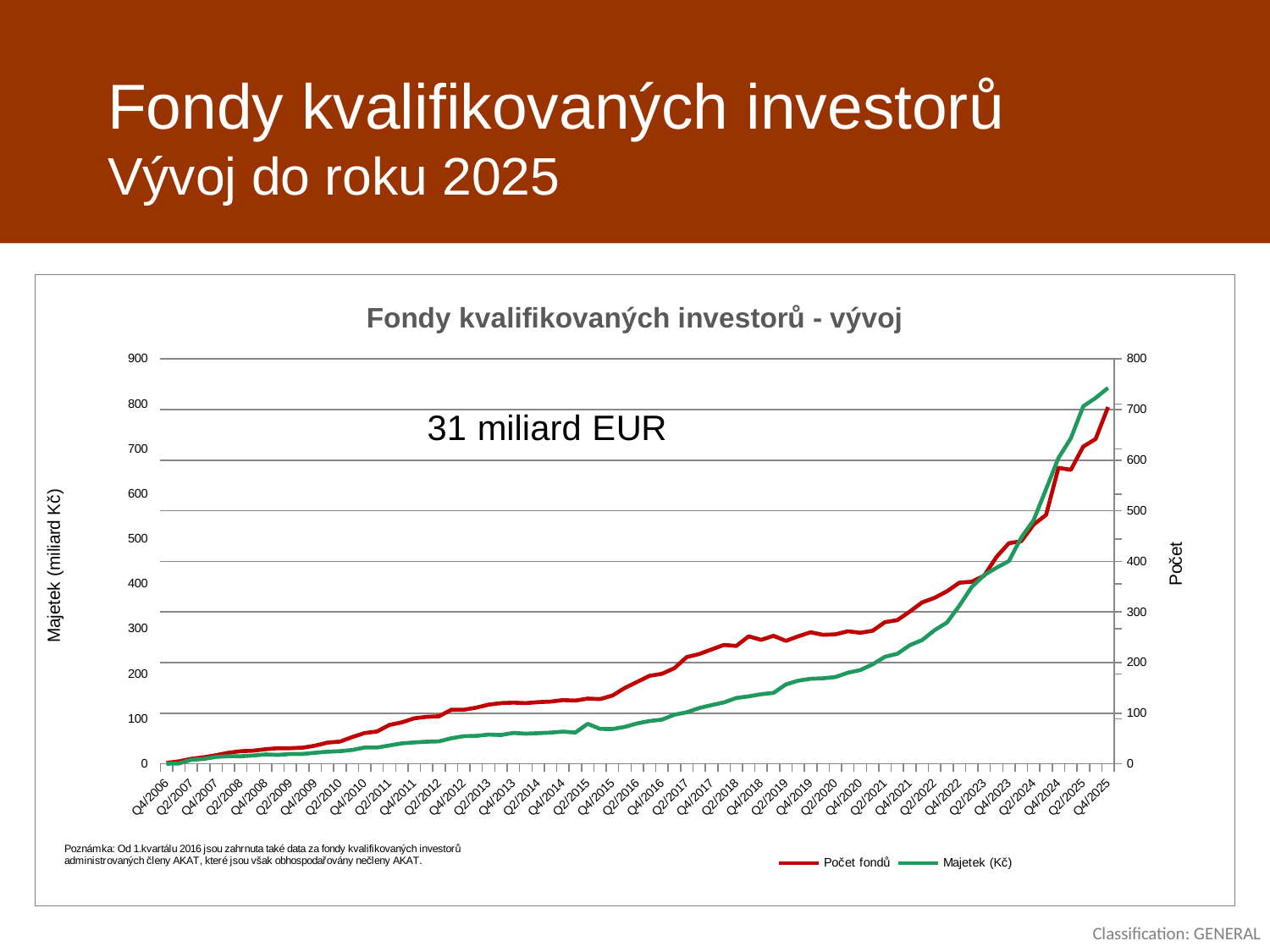
How many series does the chart legend list? 2 At Q4/2025, which line ends higher on the chart, Počet fondů or Majetek (Kč)? Majetek (Kč) What type of chart is shown on the slide? line chart What is the title of the chart? Fondy kvalifikovaných investorů - vývoj What is the overall trend of the Majetek (Kč) line from Q4/2006 to Q4/2025? rising What value annotation is printed inside the plot area of the chart? 31 miliard EUR Read against the left axis, is the Majetek (Kč) line at Q4/2015 greater or less than 100? less Which series is drawn in red according to the legend? Počet fondů What is the overall trend of the Počet fondů line across the x axis? rising Read against the left axis, is the Majetek (Kč) line at Q4/2025 greater or less than 800? greater What is the first period label on the x axis of the chart? Q4/2006 Around Q4/2015, which line is higher on the chart, Počet fondů or Majetek (Kč)? Počet fondů